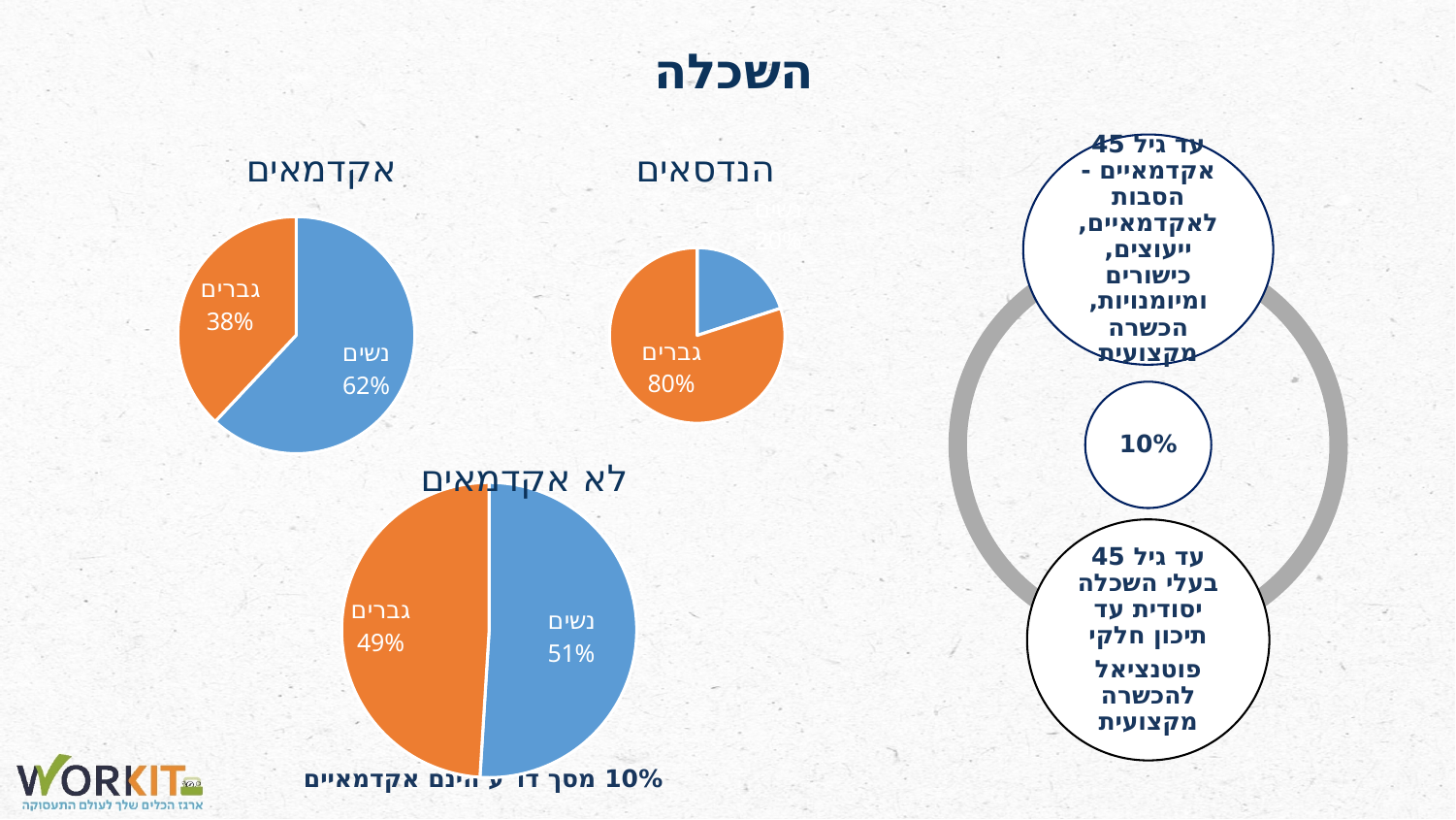
How many pie charts are shown on the slide? 3 In the pie chart titled אקדמאים, which slice is larger, נשים or גברים? נשים In the pie chart titled אקדמאים, what share is labelled for גברים? 38% In the pie chart titled לא אקדמאים, what is the difference in percentage points between the נשים and גברים slices? 2 In the pie chart titled לא אקדמאים, what share is labelled for נשים? 51% In the pie chart titled אקדמאים, what share is labelled for נשים? 62% In the pie chart titled אקדמאים, what colour is the גברים slice? Orange In the pie chart titled הנדסאים, what share is labelled for גברים? 80% What type of chart is used for אקדמאים, הנדסאים and לא אקדמאים on this slide? Pie chart In the pie chart titled אקדמאים, what is the difference in percentage points between the נשים and גברים slices? 24 In the pie chart titled לא אקדמאים, what share is labelled for גברים? 49% In the pie chart titled לא אקדמאים, which slice is larger, נשים or גברים? נשים